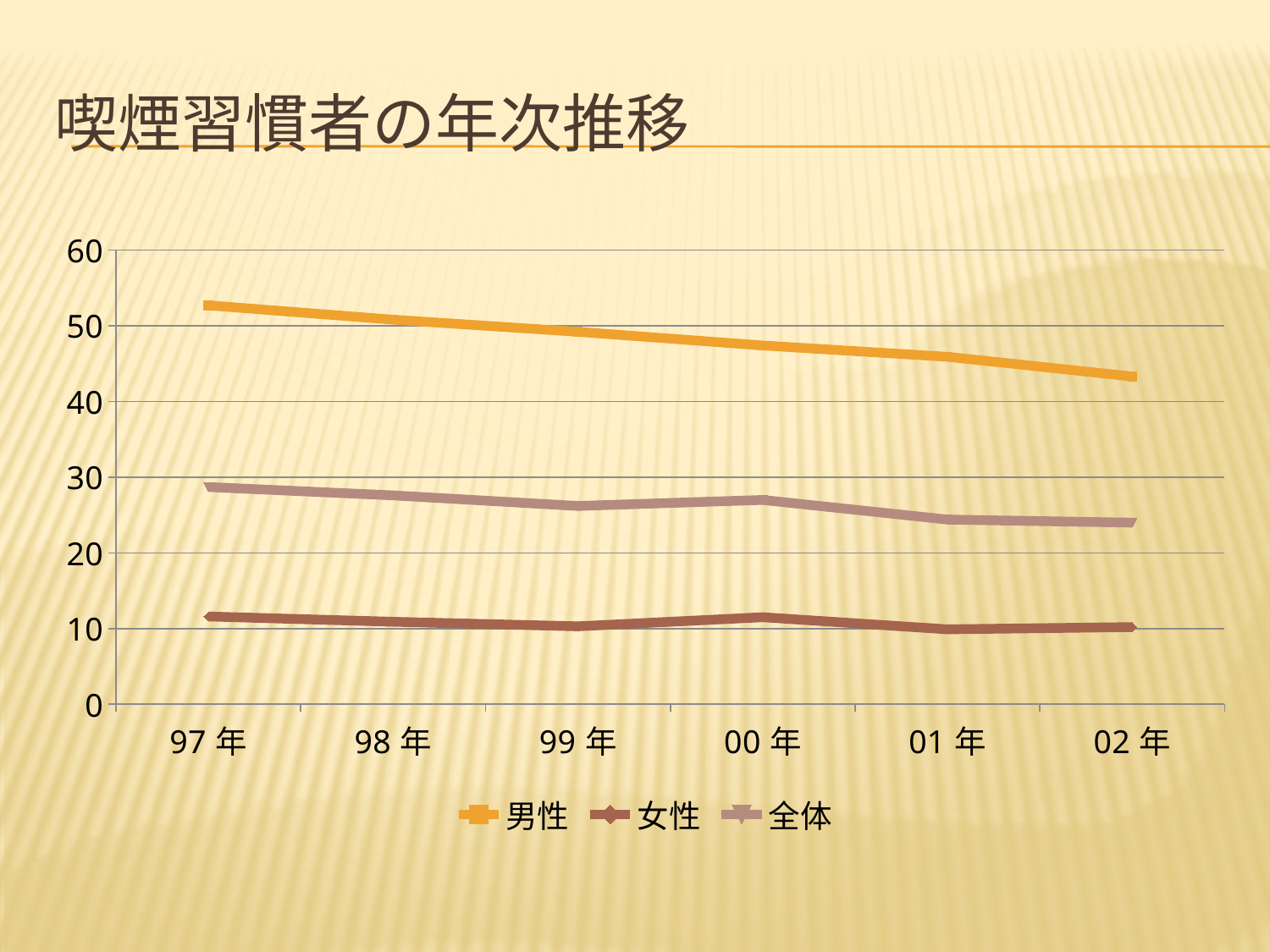
Does the 男性 line rise or fall from 97年 to 02年? fall Is the value for 男性 in 02年 greater or less than 50? less Is the value for 男性 in 97年 greater or less than 50? greater In which year is the 男性 value highest? 97年 In which year is the 男性 value lowest? 02年 Which is larger in 97年, the 男性 value or the 女性 value? 男性 What is the title of the chart? 喫煙習慣者の年次推移 What kind of chart is shown on the slide? line chart How many series does the legend list? 3 Which series is drawn in orange? 男性 How many years are plotted along the x axis? 6 Is the value for 全体 in 02年 greater or less than 30? less